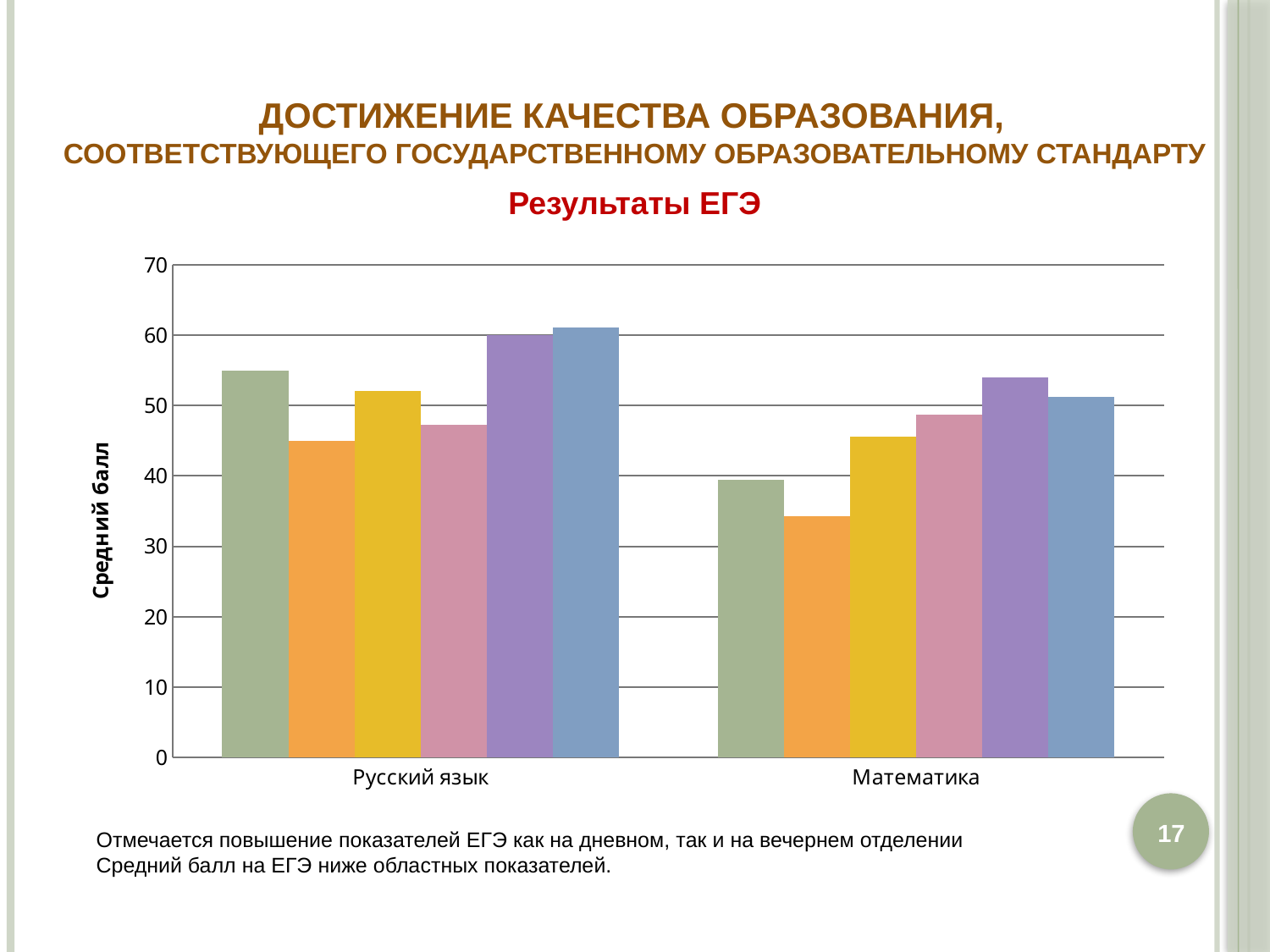
How many bars are plotted for the Математика category? 6 What kind of chart is shown on the slide? bar chart How many categories are shown on the x axis of the chart? 2 Is the value of the orange bar for Математика greater or less than 40? less What is the label of the vertical axis? Средний балл Which bar is the highest in the Математика category? the purple bar Is the value of the orange bar for Русский язык greater or less than 50? less Is the green bar larger for Русский язык or for Математика? Русский язык Is the value of the green bar for Русский язык greater or less than 50? greater Which bar is the lowest in the Математика category? the orange bar What is the title of the chart? Результаты ЕГЭ